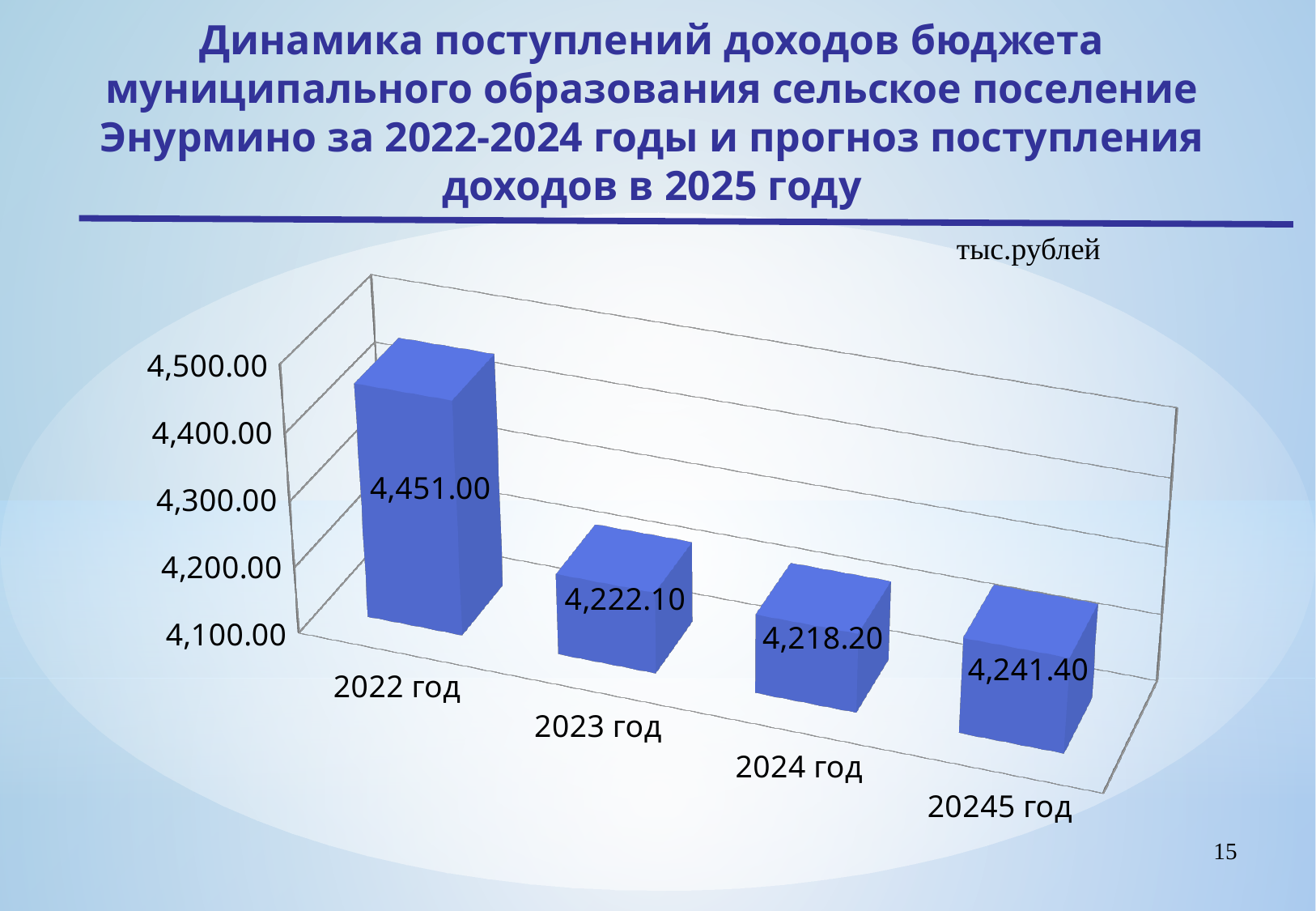
What is the value for 2024 год? 4,218.20 Is the value for 2022 год greater or less than 4,400.00? greater What is the difference between the values for 20245 год and 2024 год? 23.20 What is the value for the category labelled 20245 год? 4,241.40 What is the difference between the values for 2022 год and 2023 год? 228.90 What kind of chart is shown on the slide? bar chart Which category has the highest value? 2022 год Which category has the lowest value? 2024 год How many categories are shown on the chart? 4 Which is larger, the value for 2023 год or the value for 20245 год? 20245 год What is the value for 2023 год? 4,222.10 What is the value for 2022 год? 4,451.00